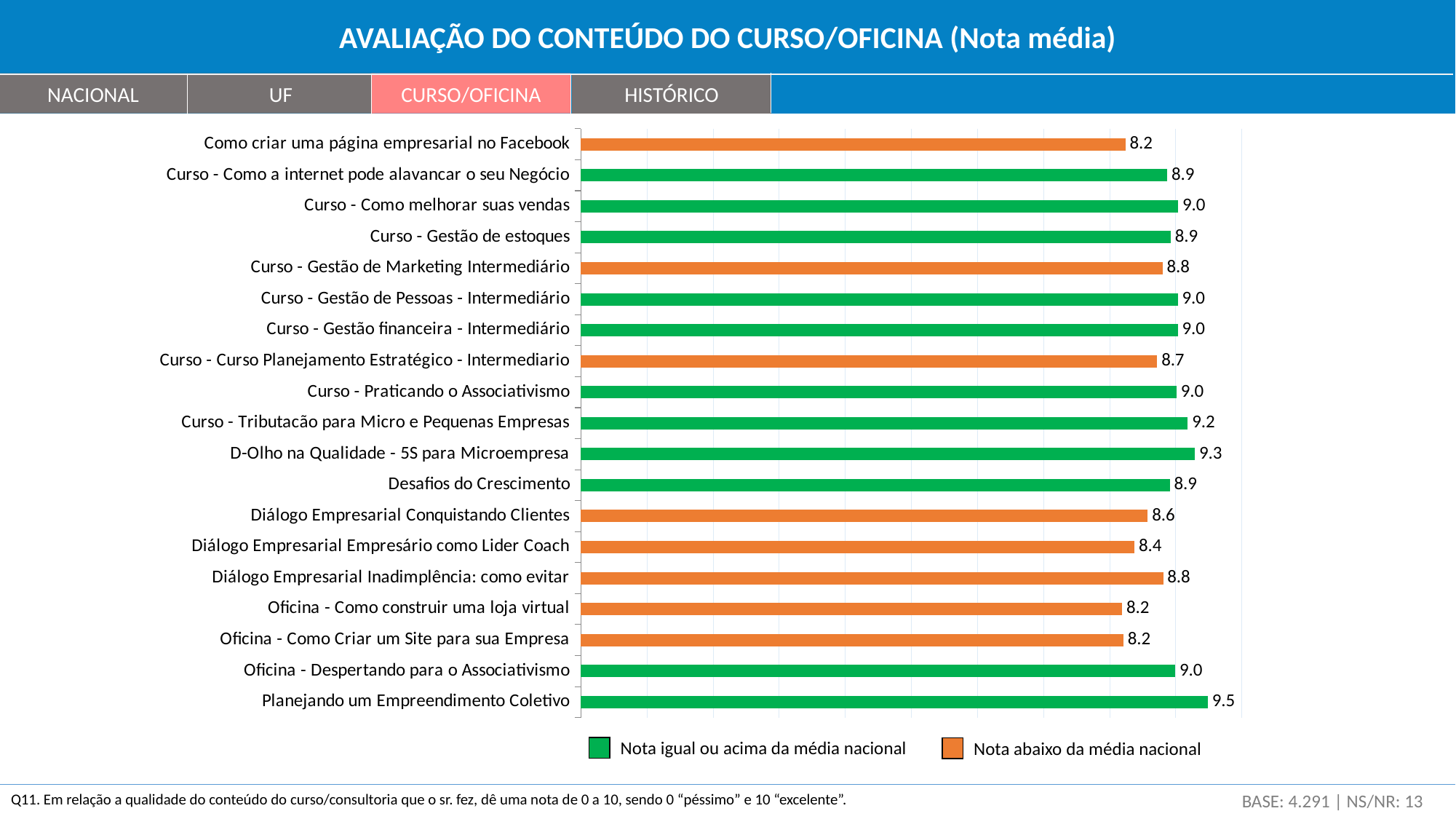
How many bars are coloured orange (below the national average)? 8 What is the difference between the scores for 'D-Olho na Qualidade - 5S para Microempresa' and 'Como criar uma página empresarial no Facebook'? 1.1 How many courses/workshops are listed on the chart? 19 What is the average score for 'Diálogo Empresarial Empresário como Lider Coach'? 8.4 What is the average score for 'Curso - Tributacão para Micro e Pequenas Empresas'? 9.2 What kind of chart is shown on the slide? Bar chart Which course/workshop has the highest average score? Planejando um Empreendimento Coletivo What is the lowest average score shown on the chart? 8.2 Which has a higher score: 'Curso - Gestão de estoques' or 'Diálogo Empresarial Conquistando Clientes'? Curso - Gestão de estoques What is the average score for 'Planejando um Empreendimento Coletivo'? 9.5 According to the legend, what does a green bar indicate? Nota igual ou acima da média nacional How many entries does the legend list? 2